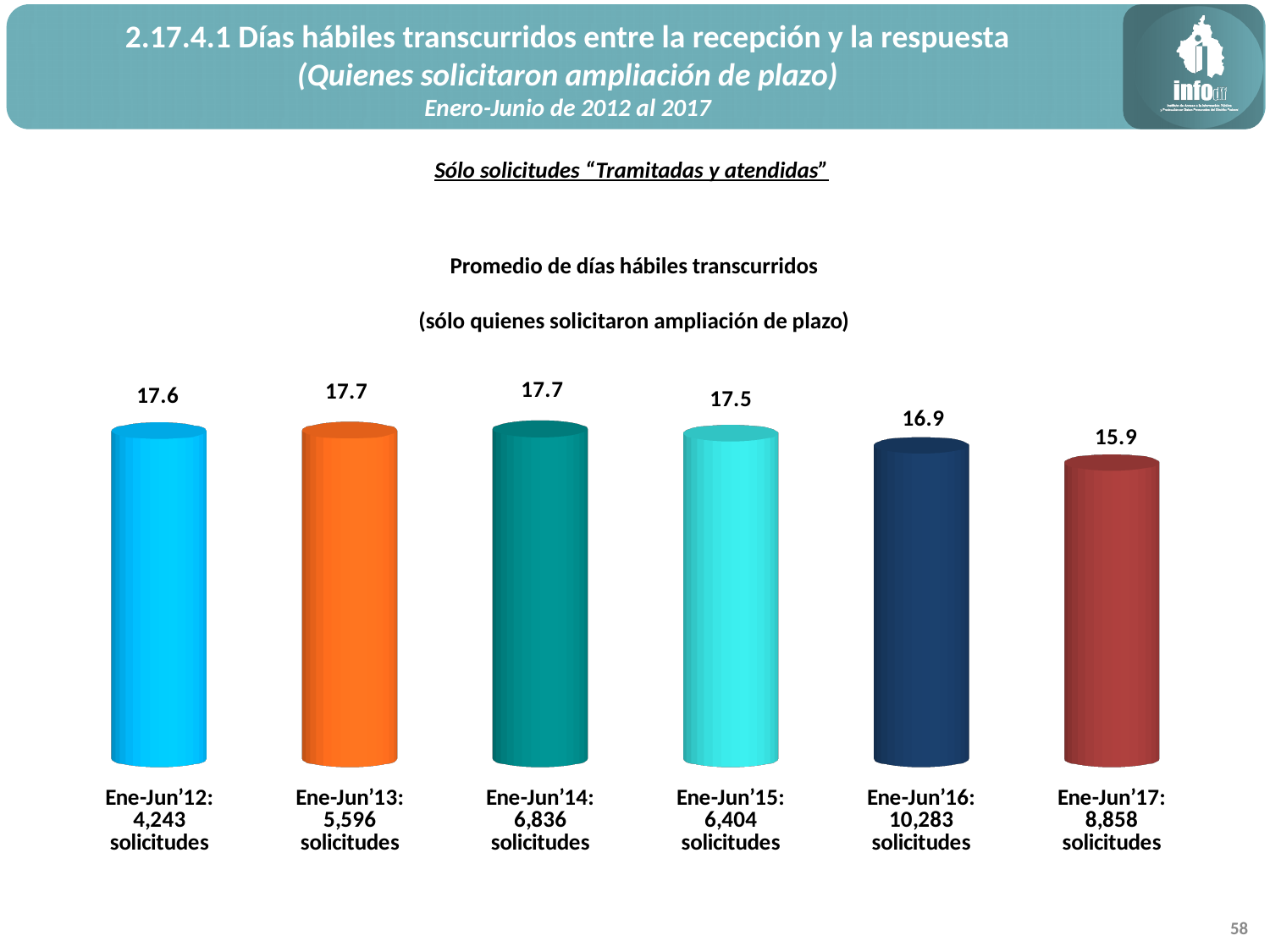
Which period has the lowest average number of business days? Ene-Jun'17 What is the difference between the values for Ene-Jun'14 and Ene-Jun'17? 1.8 What is the average number of business days for Ene-Jun'12? 17.6 What is the difference between the values for Ene-Jun'15 and Ene-Jun'16? 0.6 What is the value shown for Ene-Jun'16? 16.9 What is the value shown for Ene-Jun'17? 15.9 How many periods are shown in the chart? 6 How many solicitudes are indicated for Ene-Jun'16 in the category label? 10,283 solicitudes What is the title of the chart? Promedio de días hábiles transcurridos (sólo quienes solicitaron ampliación de plazo) Which is larger, the value for Ene-Jun'13 or the value for Ene-Jun'16? Ene-Jun'13 Do the values generally rise or fall from Ene-Jun'14 to Ene-Jun'17? Fall What kind of chart is shown on the slide? Bar chart